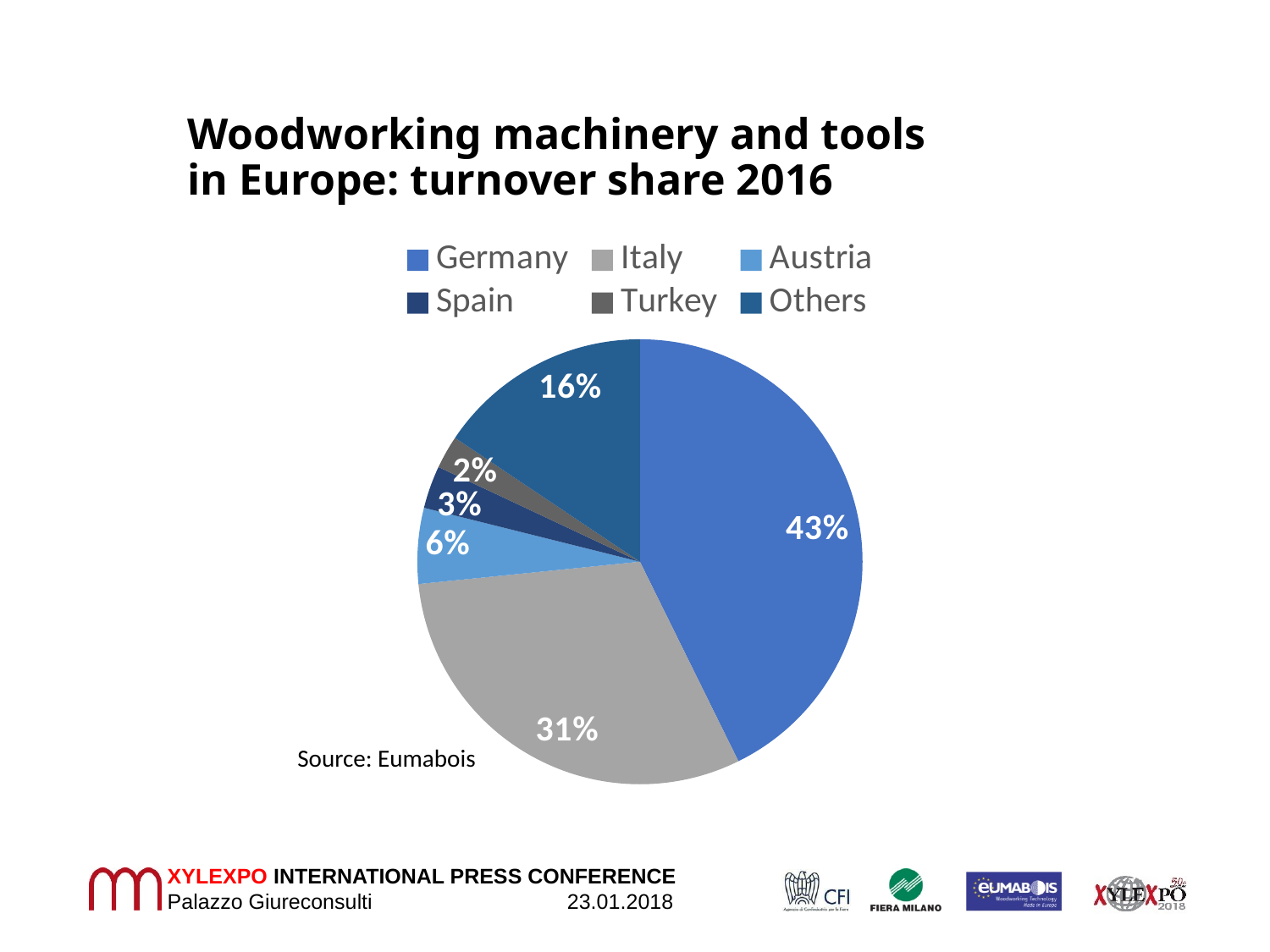
Which has a larger turnover share, Austria or Spain? Austria What share of turnover does Germany hold? 43% What share of turnover does Turkey hold? 2% What is the source cited for the chart data? Eumabois What is the difference in turnover share between Germany and Italy? 12 percentage points Which named category has the smallest turnover share? Turkey What kind of chart is shown on the slide? Pie chart What share of turnover is attributed to Others? 16% How many categories does the pie chart show? 6 What share of turnover does Austria hold? 6% What share of turnover does Italy hold? 31% Which country has the largest turnover share? Germany